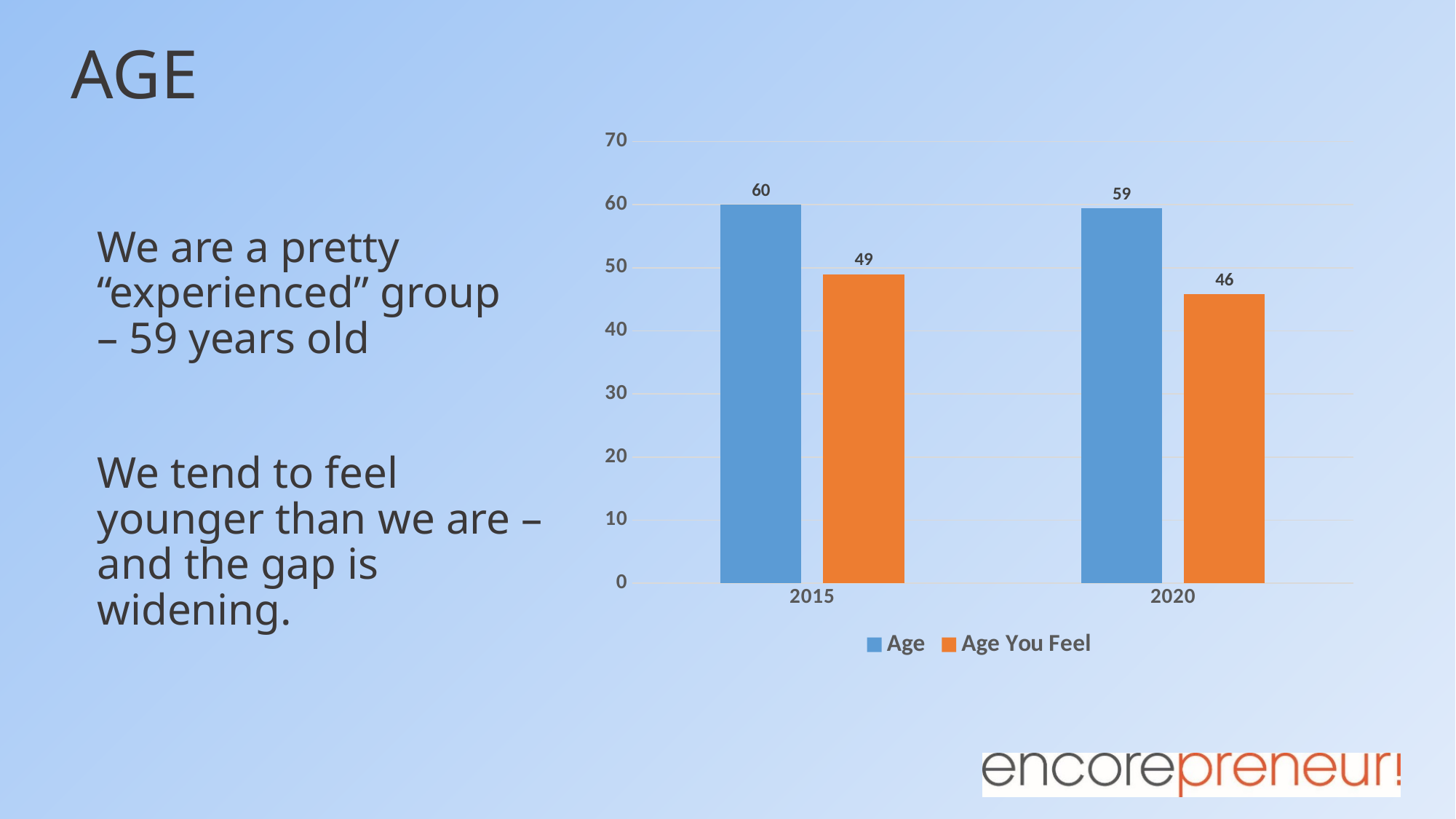
What is the value of the Age You Feel series for 2015? 49 Which year has the lowest Age You Feel value? 2020 What is the difference between Age and Age You Feel in 2015? 11 What is the value of the Age series for 2015? 60 What is the value of the Age series for 2020? 59 How many series does the legend list? 2 Which is larger in 2015, Age or Age You Feel? Age Does the Age You Feel series rise or fall from 2015 to 2020? Fall What is the difference between Age and Age You Feel in 2020? 13 What is the value of the Age You Feel series for 2020? 46 How many categories are shown on the x axis? 2 What kind of chart is shown on the slide? Bar chart